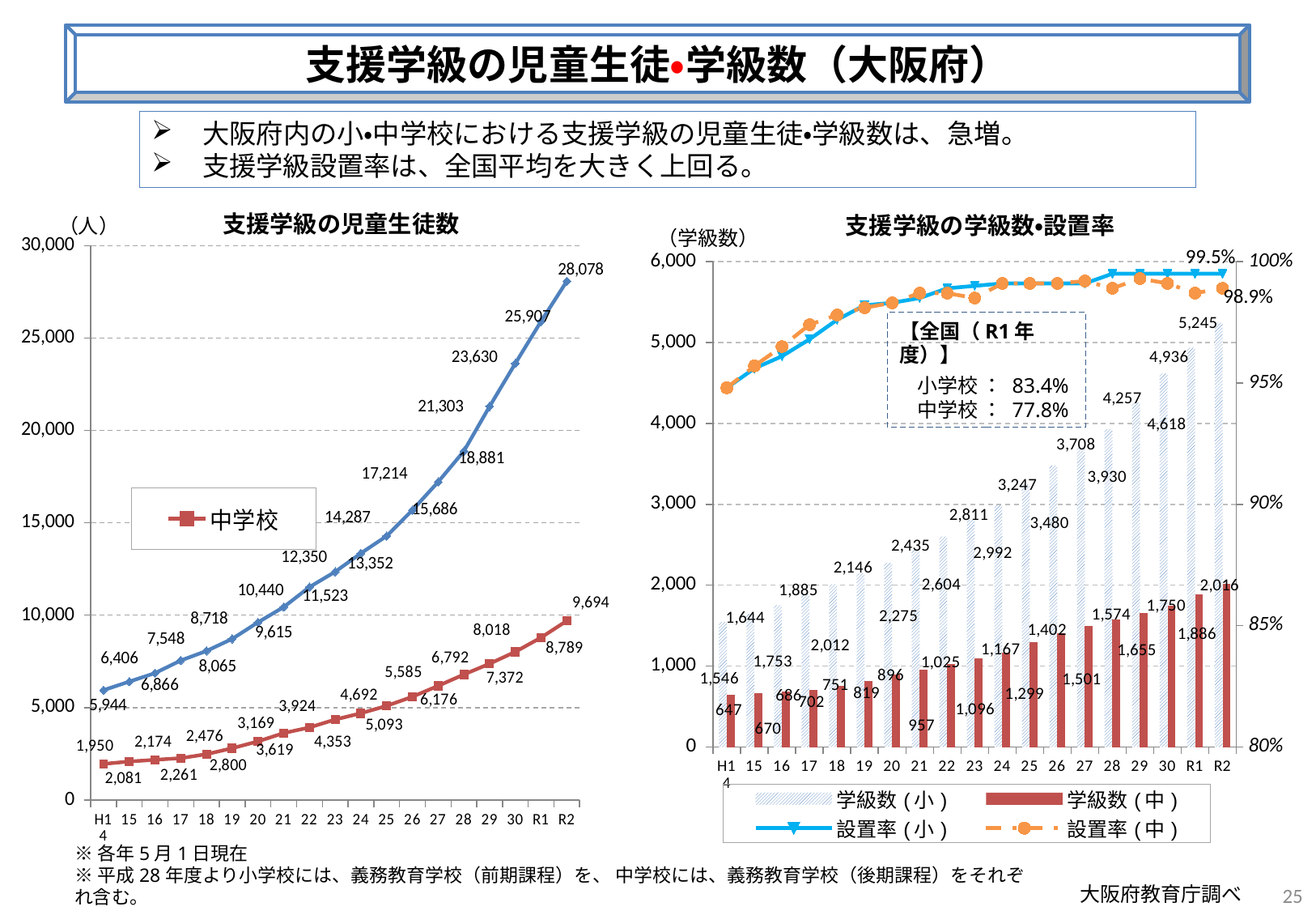
On the chart titled 支援学級の児童生徒数, how many years are plotted on the x axis? 19 On the chart titled 支援学級の児童生徒数, what is the value for 中学校 in R2? 9,694 On the chart titled 支援学級の児童生徒数, do the 中学校 values rise or fall from H14 to R2? rise On the chart titled 支援学級の学級数・設置率, what is the value for 学級数(中) in R2? 2,016 On the chart titled 支援学級の児童生徒数, what is the difference between the 中学校 values for R2 and H14? 7,744 On the chart titled 支援学級の学級数・設置率, what is the 設置率(小) value in R2? 99.5% On the chart titled 支援学級の学級数・設置率, what is the value for 学級数(小) in R2? 5,245 On the chart titled 支援学級の児童生徒数, what is the value for 中学校 in H14? 1,950 On the chart titled 支援学級の児童生徒数, in which year is the 中学校 value highest? R2 On the chart titled 支援学級の学級数・設置率, what is the difference between 学級数(小) and 学級数(中) in R2? 3,229 What kind of chart is the chart titled 支援学級の児童生徒数? line chart On the chart titled 支援学級の学級数・設置率, how many series does the legend list? 4